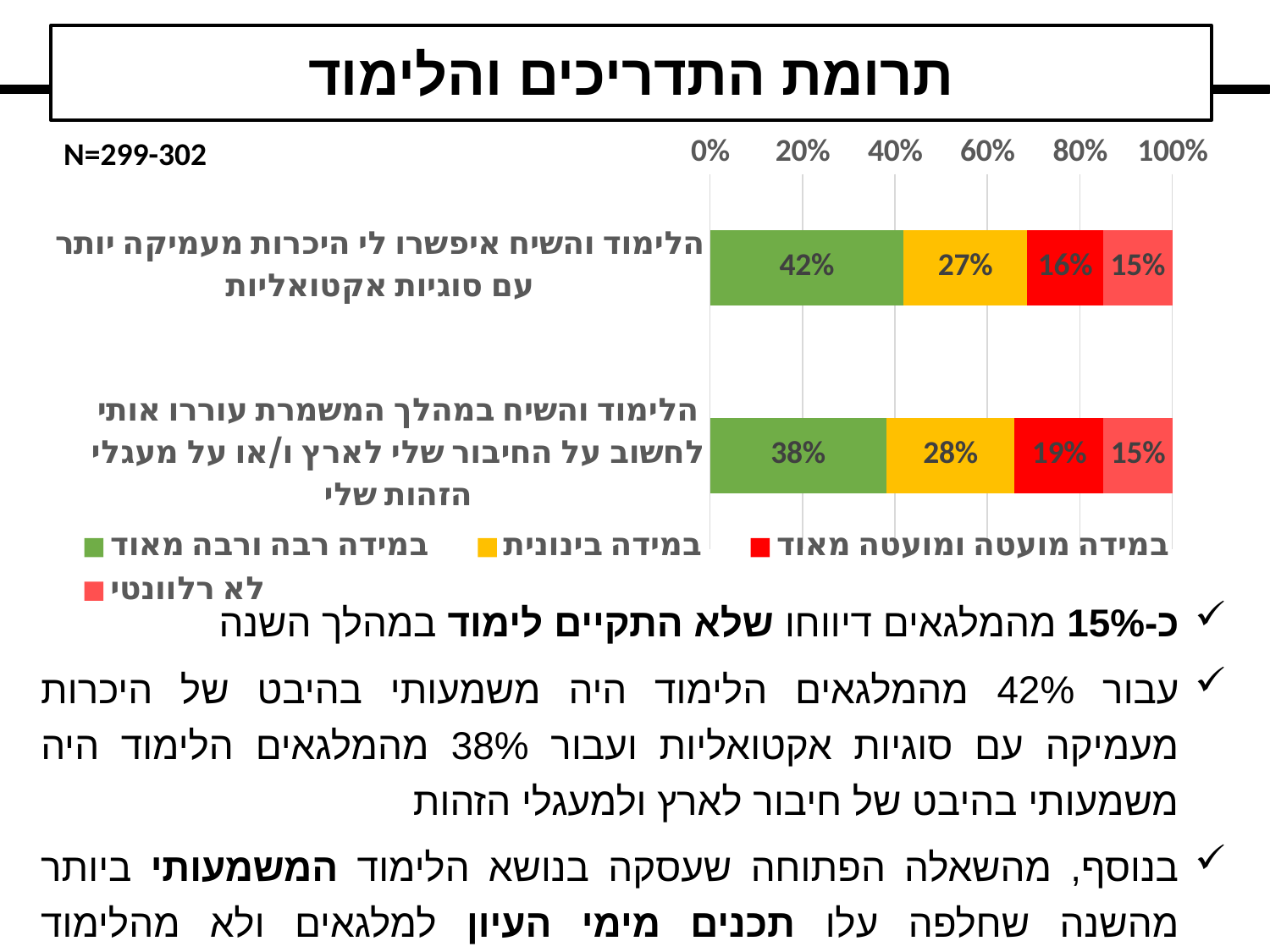
What kind of chart is shown on the slide? Stacked bar chart What is the value of the 'במידה מועטה ומועטה מאוד' segment for the bar 'הלימוד והשיח במהלך המשמרת עוררו אותי לחשוב על החיבור שלי לארץ ו/או על מעגלי הזהות שלי'? 19% Which bar has the higher 'במידה רבה ורבה מאוד' value? הלימוד והשיח איפשרו לי היכרות מעמיקה יותר עם סוגיות אקטואליות What is the value of the 'במידה רבה ורבה מאוד' segment for the bar 'הלימוד והשיח איפשרו לי היכרות מעמיקה יותר עם סוגיות אקטואליות'? 42% What is the value of the 'במידה בינונית' segment for the bar 'הלימוד והשיח במהלך המשמרת עוררו אותי לחשוב על החיבור שלי לארץ ו/או על מעגלי הזהות שלי'? 28% What is the title of the chart on the slide? תרומת התדריכים והלימוד How many categories (bars) are plotted in the chart? 2 What is the difference between the 'במידה רבה ורבה מאוד' values of the two bars (42% and 38%)? 4% What is the value of the 'לא רלוונטי' segment for the bar 'הלימוד והשיח איפשרו לי היכרות מעמיקה יותר עם סוגיות אקטואליות'? 15% What is the total of the stacked bar 'הלימוד והשיח במהלך המשמרת עוררו אותי לחשוב על החיבור שלי לארץ ו/או על מעגלי הזהות שלי'? 100% How many series does the legend list? 4 Which is larger: the 'במידה מועטה ומועטה מאוד' value for 'הלימוד והשיח איפשרו לי היכרות מעמיקה יותר עם סוגיות אקטואליות' or for 'הלימוד והשיח במהלך המשמרת עוררו אותי לחשוב על החיבור שלי לארץ ו/או על מעגלי הזהות שלי'? הלימוד והשיח במהלך המשמרת עוררו אותי לחשוב על החיבור שלי לארץ ו/או על מעגלי הזהות שלי